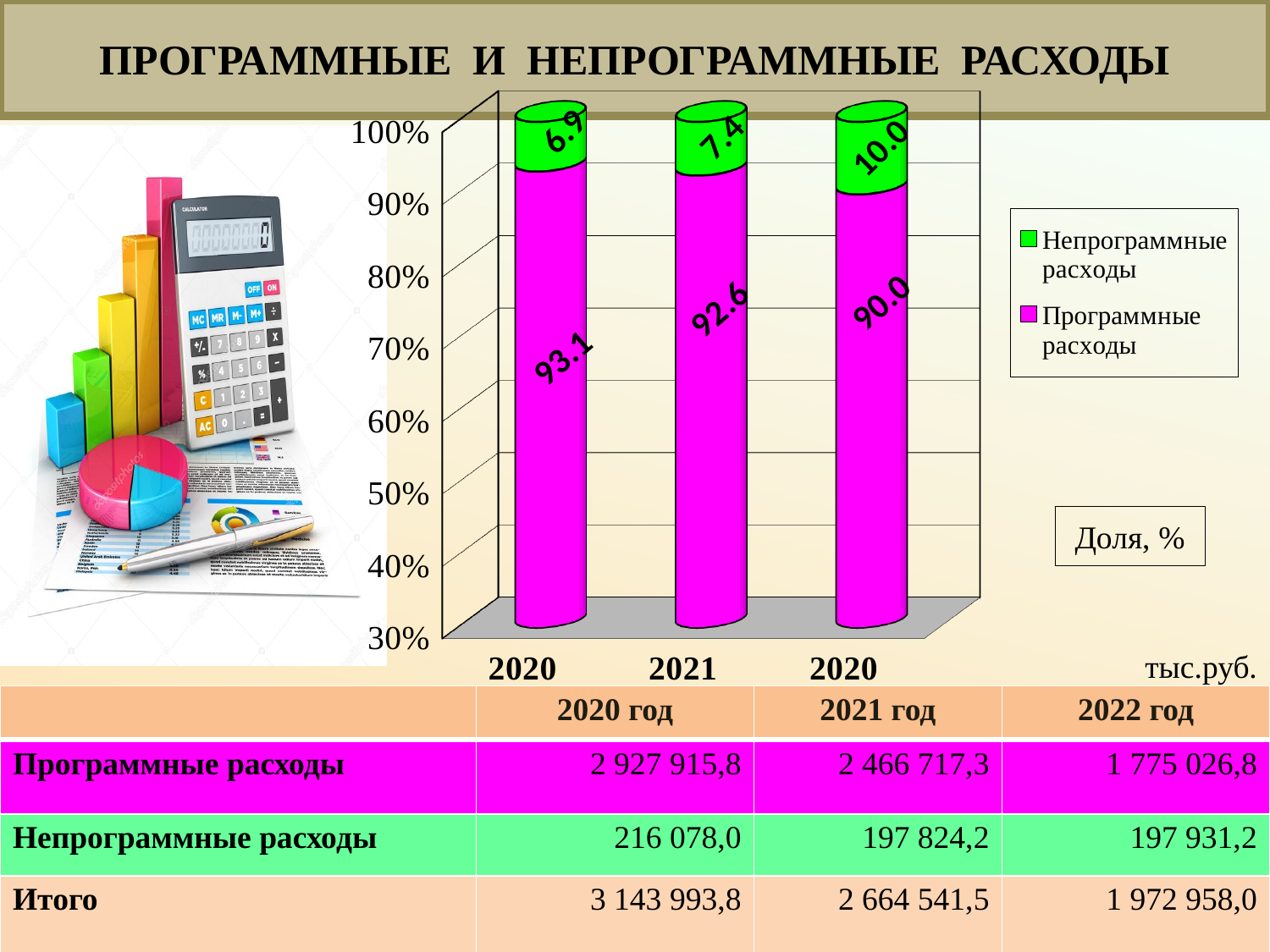
Which is larger: the Непрограммные расходы share in the 2021 bar or in the first 2020 bar? 2021 Does the share of Непрограммные расходы rise or fall from the left bar to the right bar? rise How many bars are plotted in the chart? 3 What colour represents Программные расходы in the chart? magenta What is the value of Непрограммные расходы for the rightmost bar? 10.0 How many series does the legend list? 2 What kind of chart is shown on the slide? stacked bar chart Which bar has the lowest share of Программные расходы? the rightmost bar What is the difference between the Программные расходы share in the first bar (93.1) and the rightmost bar (90.0)? 3.1 What is the value of Программные расходы for the first bar (2020)? 93.1 Which bar has the highest share of Непрограммные расходы? the rightmost bar What is the value of Непрограммные расходы for the 2021 bar? 7.4